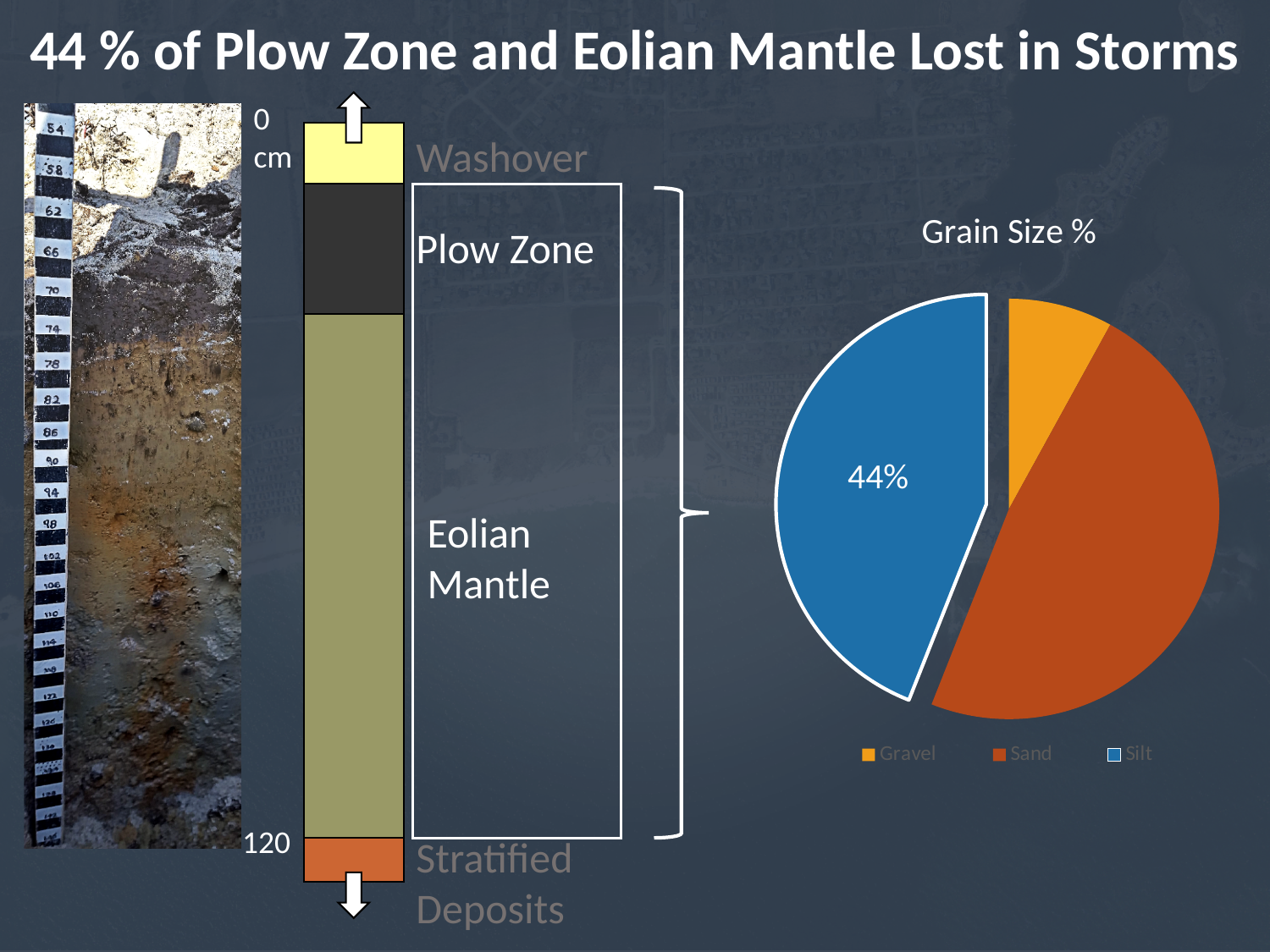
What kind of chart is shown on the slide? pie chart Which category has the largest slice in the pie chart? Sand What share of the pie chart is Silt? 44% Which slice is larger in the pie chart, Silt or Gravel? Silt Which category has the smallest slice in the pie chart? Gravel Which slice is larger in the pie chart, Sand or Gravel? Sand What value is labelled on the Silt slice of the pie chart? 44% How many categories does the pie chart's legend list? 3 What is the title of the pie chart? Grain Size % Which slice of the pie chart is pulled out from the rest? Silt How many slices does the pie chart have? 3